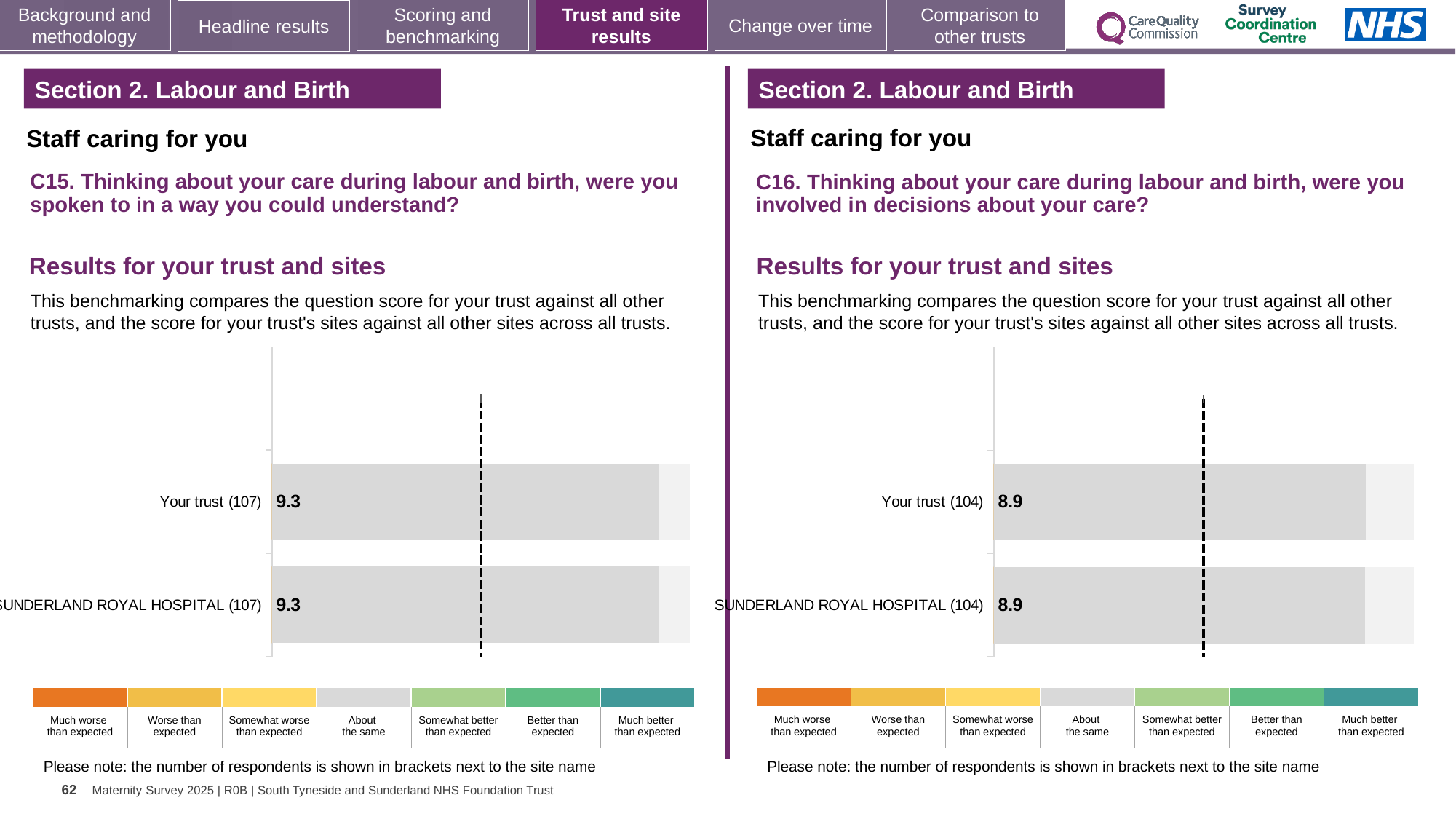
On the left chart (C15), what is the score for SUNDERLAND ROYAL HOSPITAL? 9.3 Is the score for Your trust on the left chart (C15) larger or smaller than the score for Your trust on the right chart (C16)? Larger On the right chart (C16), what is the score for SUNDERLAND ROYAL HOSPITAL? 8.9 On the right chart (C16), how many respondents are shown in brackets next to SUNDERLAND ROYAL HOSPITAL? 104 On the right chart (C16), what is the difference between the score for Your trust and the score for SUNDERLAND ROYAL HOSPITAL? 0 On the right chart (C16), what is the score for Your trust? 8.9 On the left chart (C15), what is the difference between the score for Your trust and the score for SUNDERLAND ROYAL HOSPITAL? 0 How many bars are plotted on the left chart (C15)? 2 On the left chart (C15), how many respondents are shown in brackets next to Your trust? 107 On the left chart (C15), what is the score for Your trust? 9.3 How many bars are plotted on the right chart (C16)? 2 What type of chart is used on the left (C15) to show the results for your trust and sites? Bar chart